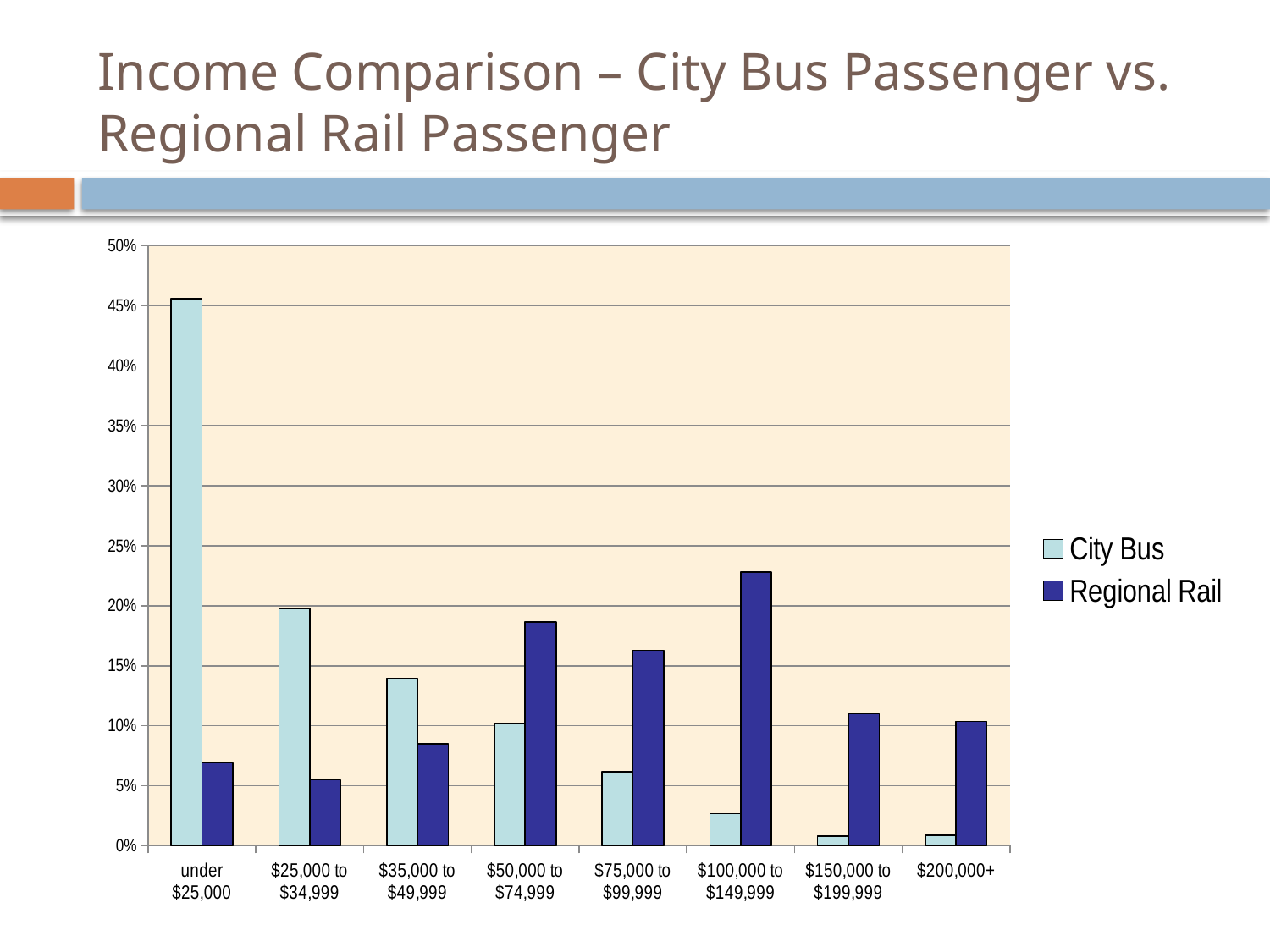
What kind of chart is shown on the slide? bar chart For the under $25,000 category, which is larger: City Bus or Regional Rail? City Bus How many series does the legend list? 2 Is the City Bus value for under $25,000 greater or less than 40%? greater Is the Regional Rail value for $50,000 to $74,999 greater or less than 15%? greater For the $150,000 to $199,999 category, which is larger: City Bus or Regional Rail? Regional Rail Which income category has the highest value for Regional Rail? $100,000 to $149,999 Is the Regional Rail value for $100,000 to $149,999 greater or less than 20%? greater Which income category has the lowest value for Regional Rail? $25,000 to $34,999 How many income categories are shown on the x axis? 8 Which income category has the highest value for City Bus? under $25,000 Do the City Bus values generally rise or fall as income increases along the x axis? fall